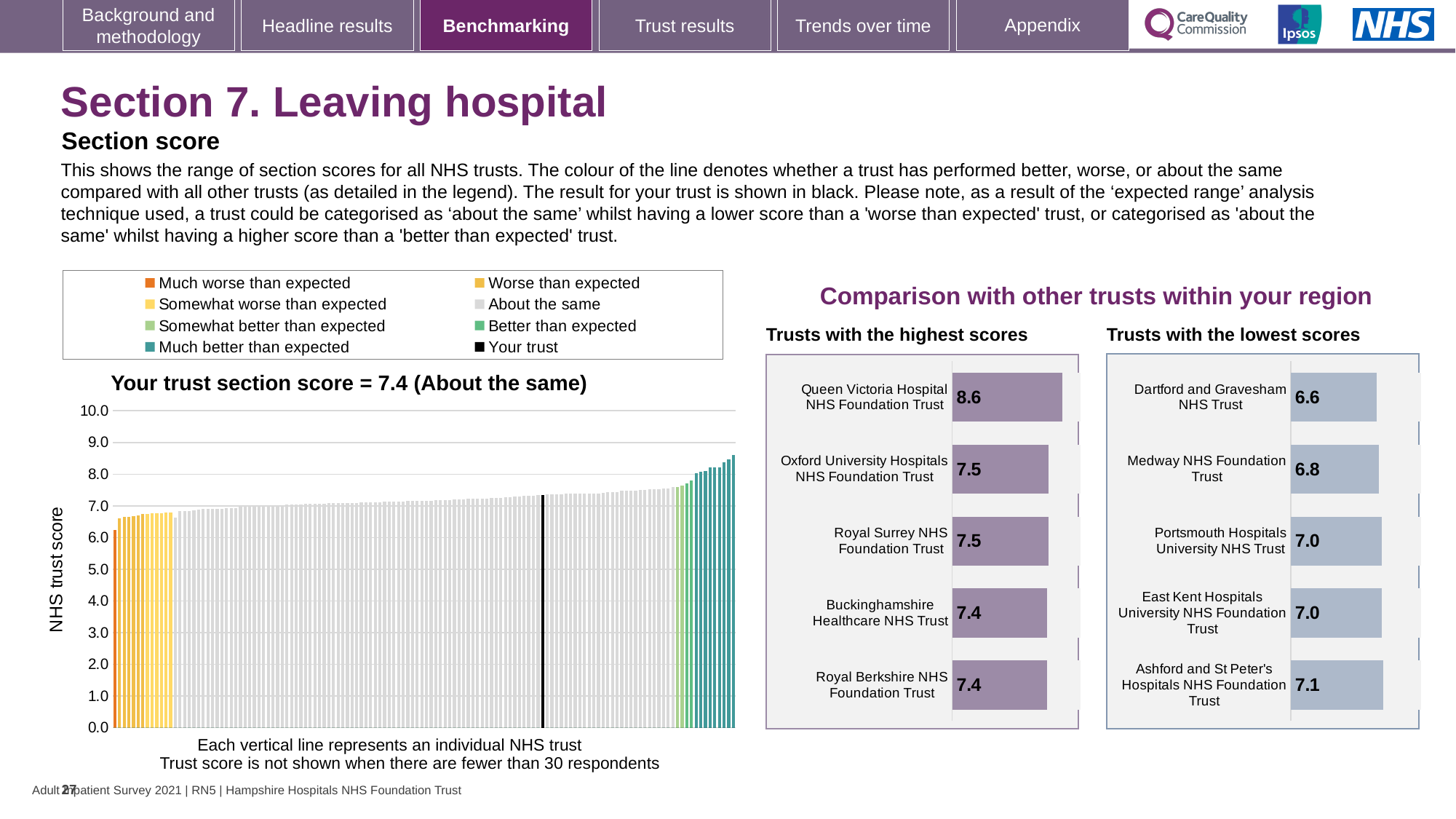
In the 'Trusts with the lowest scores' chart, what is the difference between the scores of Ashford and St Peter's Hospitals NHS Foundation Trust and Dartford and Gravesham NHS Trust? 0.5 Which has the higher score: Medway NHS Foundation Trust in the lowest scores chart or Oxford University Hospitals NHS Foundation Trust in the highest scores chart? Oxford University Hospitals NHS Foundation Trust What kind of chart is the 'Trusts with the highest scores' chart? Bar chart In the 'Trusts with the highest scores' chart, what is the score for Queen Victoria Hospital NHS Foundation Trust? 8.6 In the 'Trusts with the lowest scores' chart, what is the score for Ashford and St Peter's Hospitals NHS Foundation Trust? 7.1 In the 'Trusts with the highest scores' chart, what is the difference between the scores of Queen Victoria Hospital NHS Foundation Trust and Royal Berkshire NHS Foundation Trust? 1.2 According to the title of the main chart on the left, what is your trust's section score? 7.4 In the 'Trusts with the lowest scores' chart, which trust has the lowest score? Dartford and Gravesham NHS Trust In the 'Trusts with the lowest scores' chart, what is the score for Medway NHS Foundation Trust? 6.8 In the 'Trusts with the highest scores' chart, what is the score for Buckinghamshire Healthcare NHS Trust? 7.4 How many trusts are shown in the 'Trusts with the lowest scores' chart? 5 In the 'Trusts with the highest scores' chart, which trust has the highest score? Queen Victoria Hospital NHS Foundation Trust